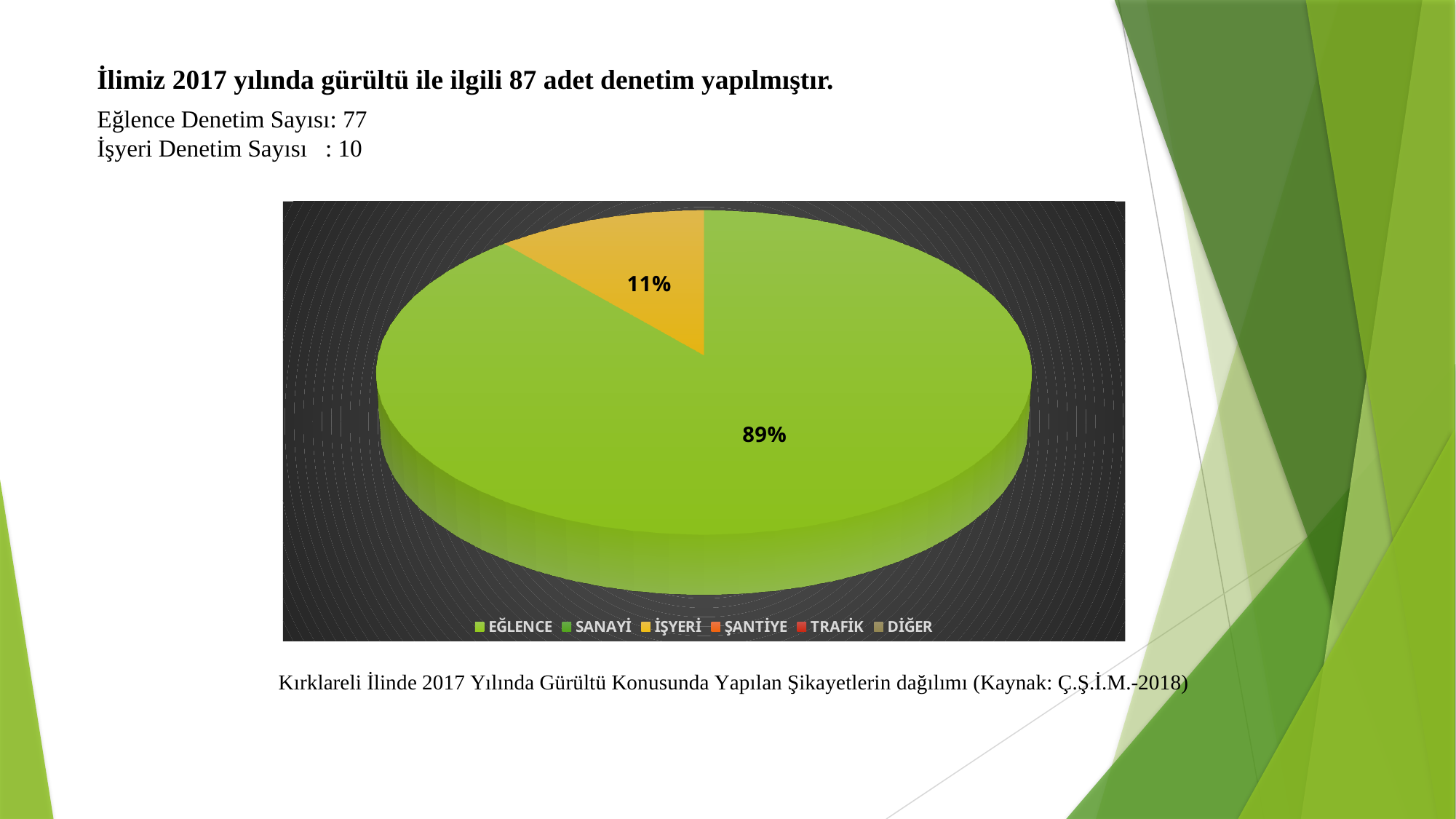
What kind of chart is shown on the slide? pie chart How many slices with percentage labels are visible in the pie chart? 2 Which of the two labelled slices is smaller, EĞLENCE or İŞYERİ? İŞYERİ Which legend entry appears last in the pie chart's legend? DİĞER How many categories does the legend of the pie chart list? 6 Is the EĞLENCE slice larger or smaller than the İŞYERİ slice? larger What share of the pie does the EĞLENCE slice represent? 89% What colour is the İŞYERİ slice in the pie chart? yellow What is the difference in percentage points between the EĞLENCE slice and the İŞYERİ slice? 78 What share of the pie does the İŞYERİ slice represent? 11% Which category has the largest slice of the pie? EĞLENCE